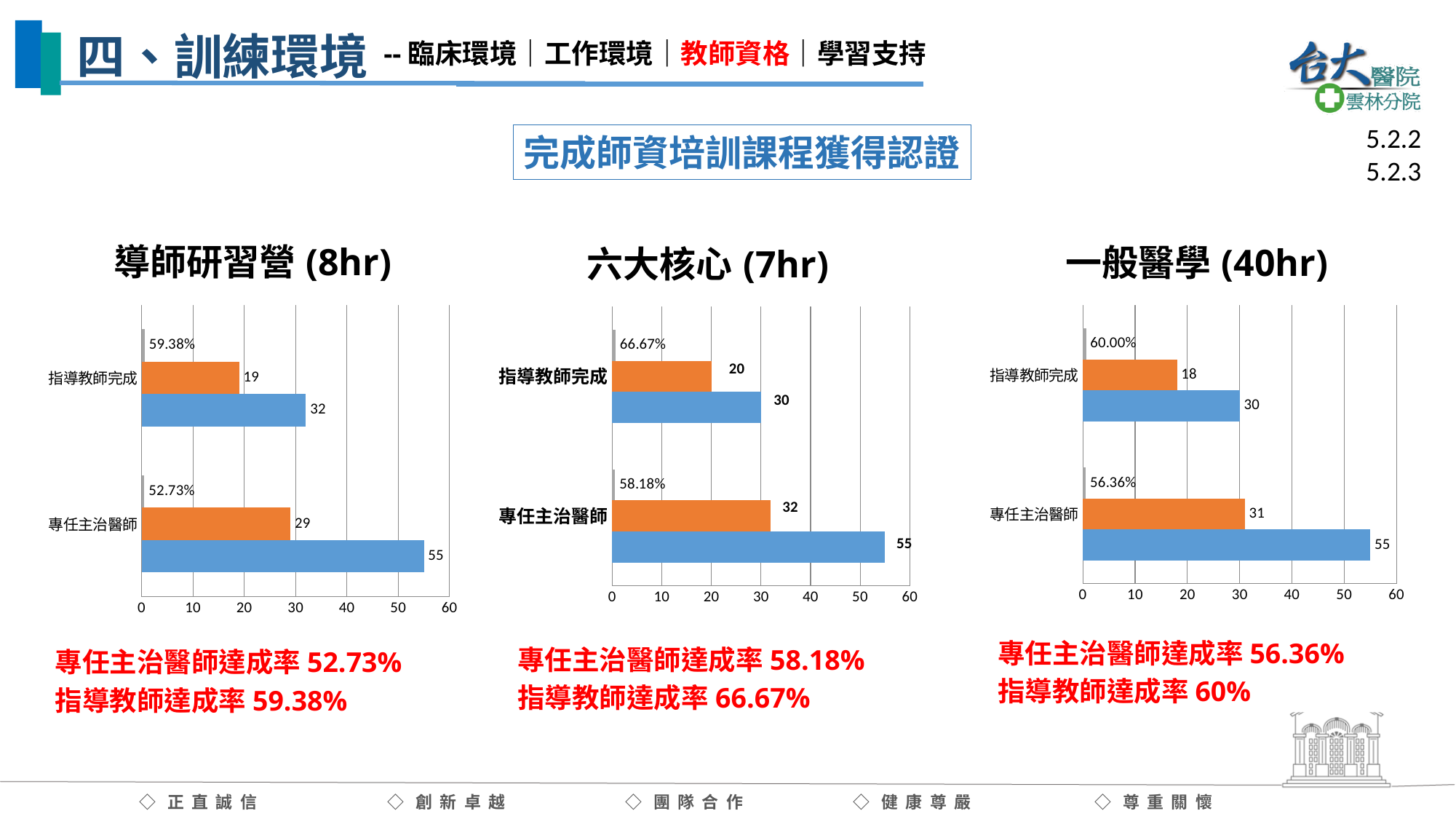
In the 導師研習營 (8hr) chart, what is the value of the blue bar for 專任主治醫師? 55 In the 六大核心 (7hr) chart, what percentage is labelled for 指導教師完成? 66.67% In the 導師研習營 (8hr) chart, what percentage is labelled for 專任主治醫師? 52.73% What kind of chart is the 六大核心 (7hr) chart? bar chart In the 一般醫學 (40hr) chart, what is the difference between the blue bar and the orange bar for 專任主治醫師? 24 How many charts are shown on the slide? 3 In the 一般醫學 (40hr) chart, what is the value of the blue bar for 指導教師完成? 30 In the 六大核心 (7hr) chart, which is larger: the orange bar for 專任主治醫師 or the orange bar for 指導教師完成? 專任主治醫師 In the 六大核心 (7hr) chart, what is the value of the orange bar for 專任主治醫師? 32 In the 導師研習營 (8hr) chart, is the blue bar for 指導教師完成 greater or less than 40? less How many categories are shown on the y axis of the 一般醫學 (40hr) chart? 2 In the 導師研習營 (8hr) chart, what is the value of the orange bar for 指導教師完成? 19